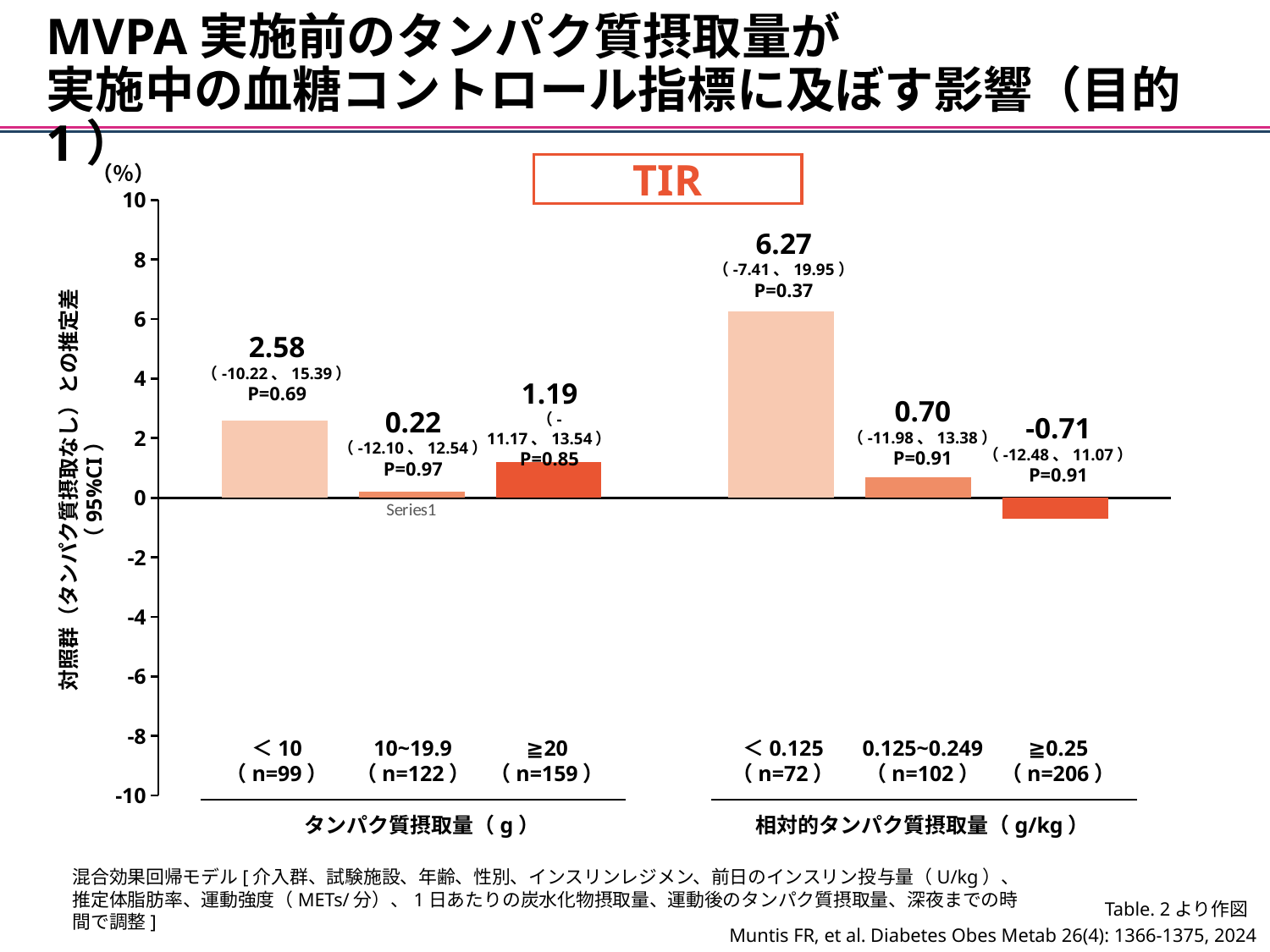
What is the difference between the values for the <0.125 (n=72) group and the 0.125~0.249 (n=102) group? 5.57 What kind of chart is shown on the slide? bar chart How many bars are plotted in the chart? 6 What is the value for the <0.125 (n=72) relative protein intake group? 6.27 What is the title shown in the box above the chart? TIR What is the value for the <10 (n=99) protein intake group? 2.58 Which group has the highest value? <0.125 (n=72) Which group has the lowest value? ≧0.25 (n=206) What is the value for the ≧0.25 (n=206) group? -0.71 What is the P value shown for the 10~19.9 (n=122) group? P=0.97 Which is larger, the value for the <10 (n=99) group or the ≧20 (n=159) group? <10 (n=99) Is the value for the <0.125 (n=72) group greater or less than 4? greater